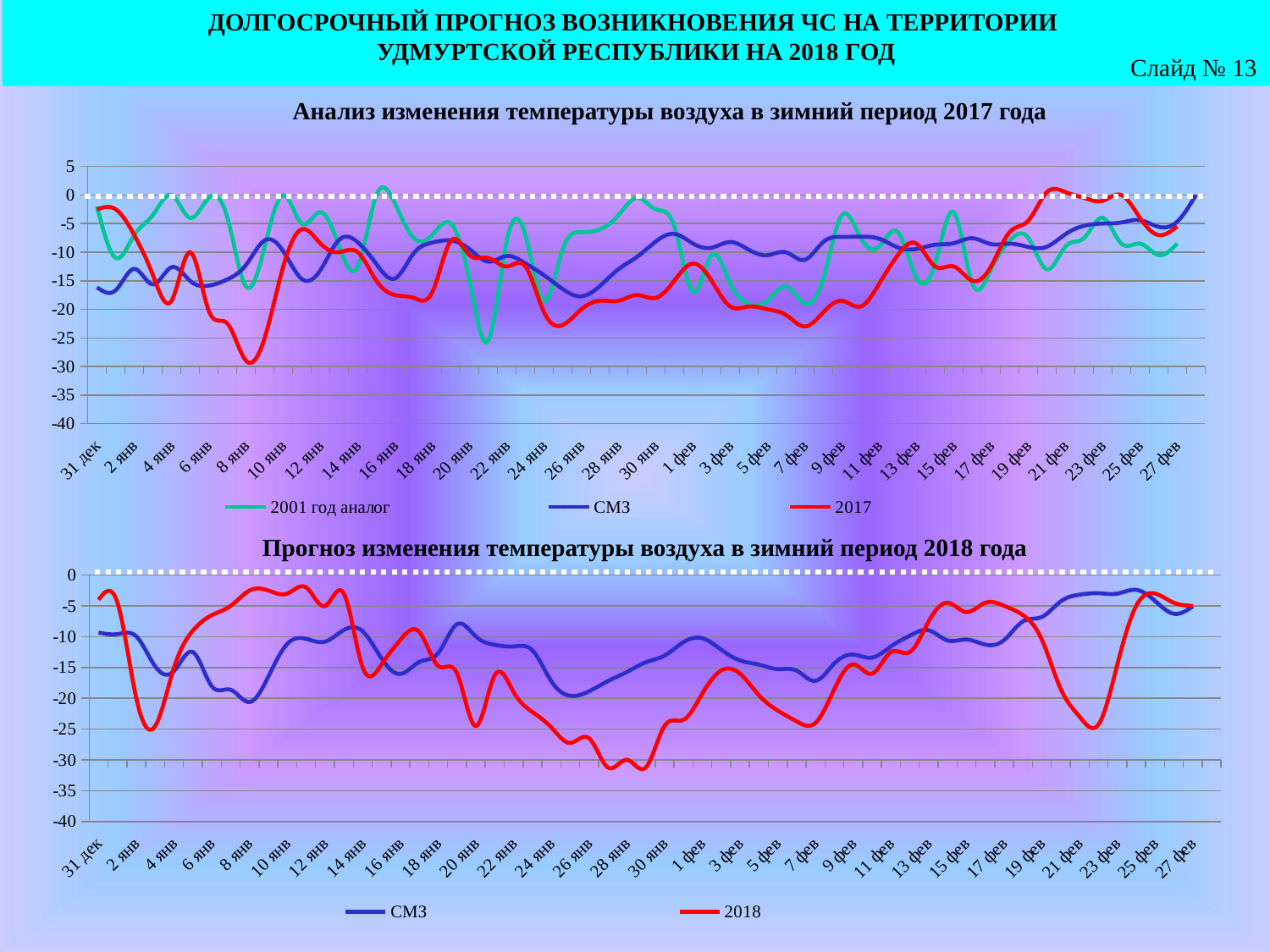
In the top chart (2017 analysis), is the value of the 2001 год аналог series around 21 янв greater or less than -20? less In the top chart (2017 analysis), is the value of the 2017 series around 8 янв greater or less than -25? less In the top chart (2017 analysis), which series is drawn in green according to the legend? 2001 год аналог What kind of chart is the top chart, 'Анализ изменения температуры воздуха в зимний период 2017 года'? Line chart In the bottom chart (2018 forecast), is the value of the 2018 series around 28 янв greater or less than -25? less In the bottom chart (2018 forecast), which series is drawn in red according to the legend? 2018 How many series does the legend of the bottom chart (2018 forecast) list? 2 In the bottom chart (2018 forecast), which series reaches the lowest temperature, СМЗ or 2018? 2018 In the top chart (2017 analysis), which series reaches the lowest temperature, СМЗ or 2017? 2017 In the bottom chart (2018 forecast), does the 2018 series rise or fall between 21 фев and 25 фев? rise How many series does the legend of the top chart (2017 analysis) list? 3